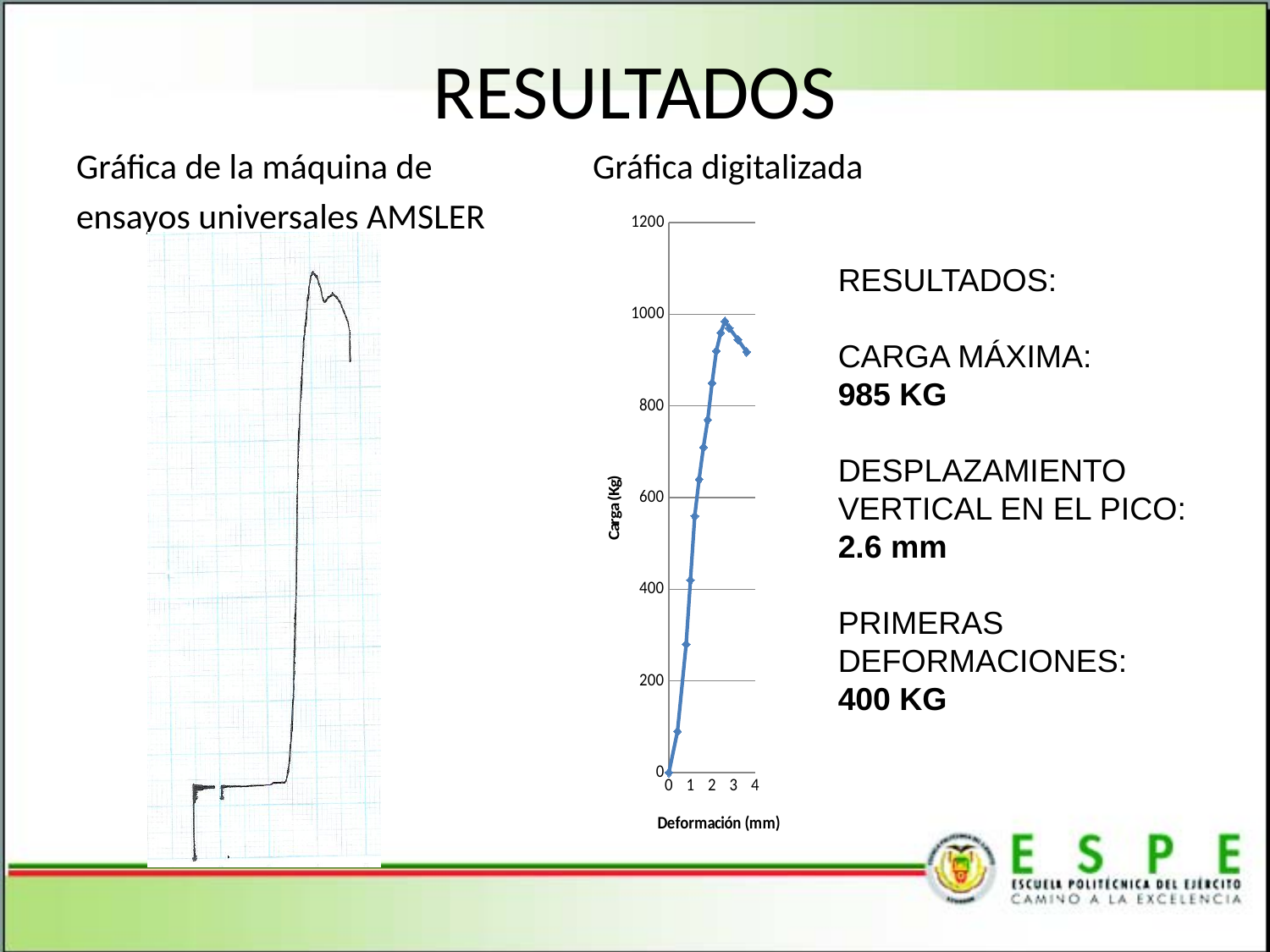
In the 'Gráfica digitalizada' chart, does the load rise or fall after the peak, between about 3 and 4 mm of deformation? fall In the 'Gráfica digitalizada' chart, what is the highest tick value shown on the horizontal axis? 4 In the 'Gráfica digitalizada' chart, what is the highest tick value shown on the vertical axis? 1200 In the 'Gráfica digitalizada' chart, what is the label of the vertical axis? Carga (Kg) According to the slide, at what vertical displacement does the peak of the digitized chart occur? 2.6 mm In the 'Gráfica digitalizada' chart, is the peak load greater or less than 800? greater According to the slide, what is the maximum load (carga máxima) reached in the test shown in the digitized chart? 985 KG In the 'Gráfica digitalizada' chart, what is the label of the horizontal axis? Deformación (mm) In the 'Gráfica digitalizada' chart, is the load at a deformation of 2 mm greater or less than 600? greater In the 'Gráfica digitalizada' chart, does the load rise or fall as deformation increases from 0 to 2 mm? rise What kind of chart is the 'Gráfica digitalizada'? line chart